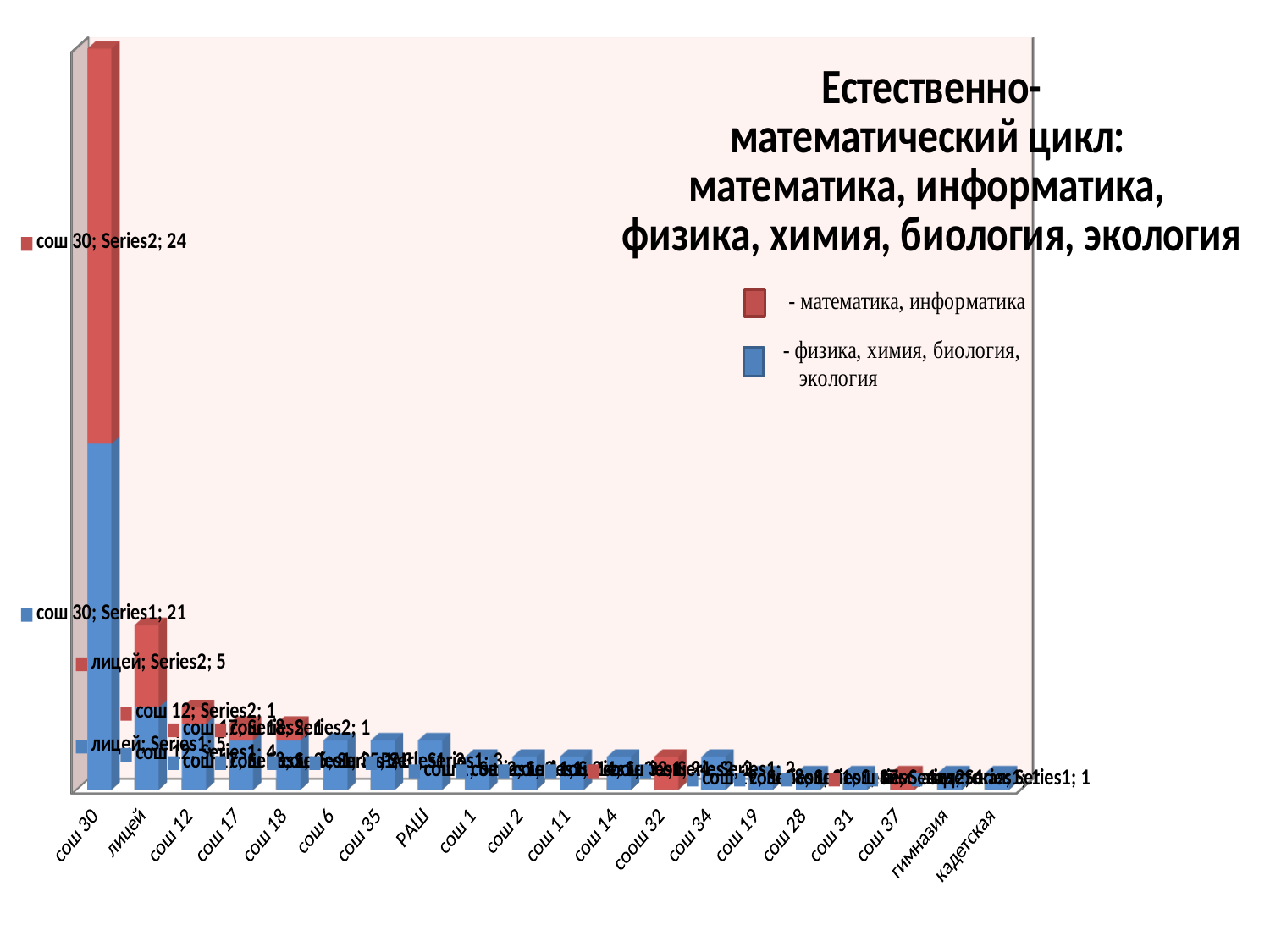
What is the total of the stacked bar for сош 30? 45 What is the difference between the Series2 and Series1 values for сош 30? 3 What kind of chart is shown on the slide? bar chart Which subjects does the red colour represent in the legend? математика, информатика How many series does the legend list? 2 What is the Series1 (физика, химия, биология, экология) value for сош 30? 21 How many school categories are shown along the x axis? 20 What is the Series2 value for лицей? 5 Which has the larger Series2 value, сош 30 or лицей? сош 30 Which school has the tallest stacked bar? сош 30 Do the bar heights generally rise or fall from left to right along the x axis? fall What is the Series2 (математика, информатика) value for сош 30? 24